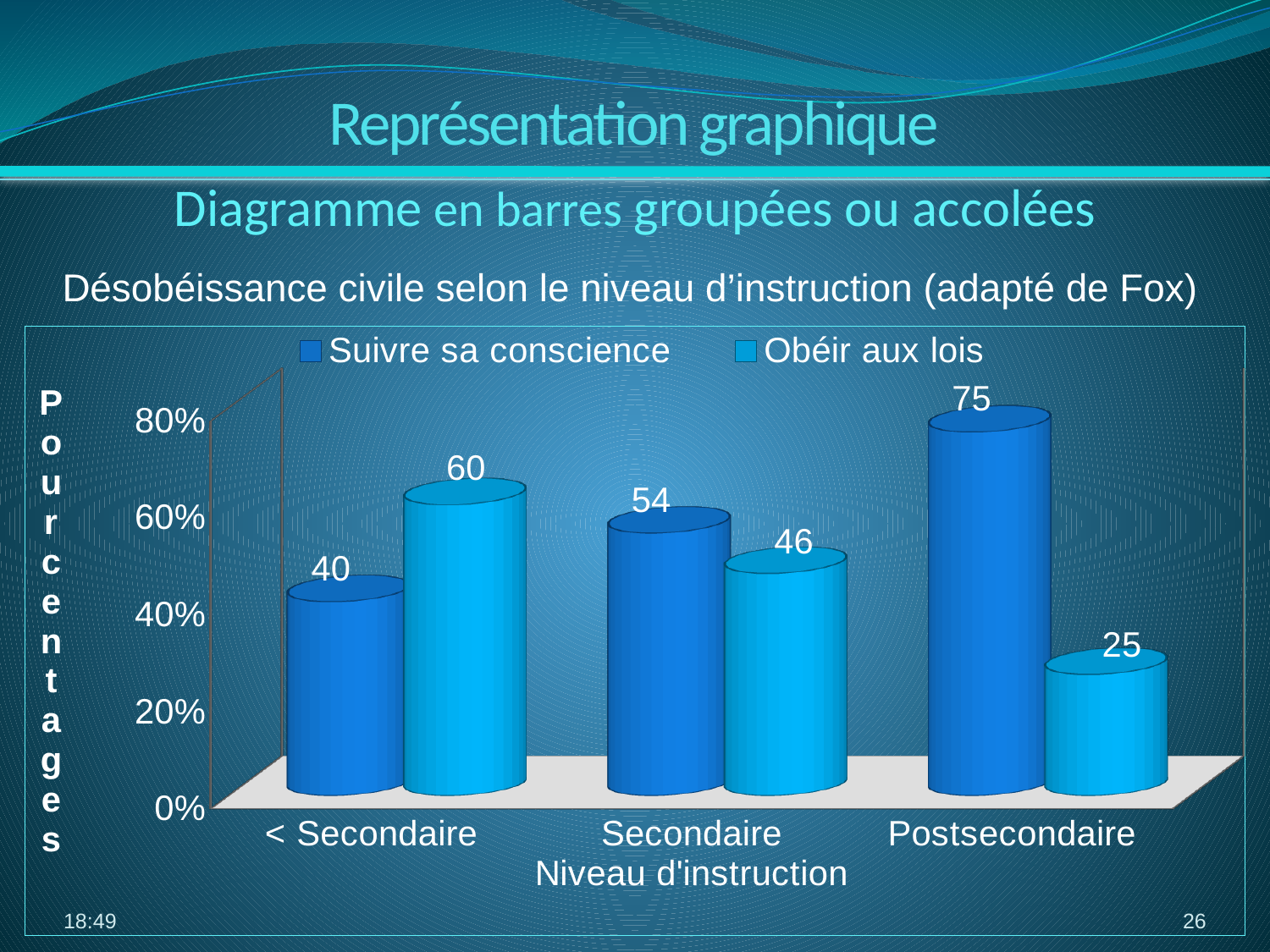
What is the difference between "Suivre sa conscience" and "Obéir aux lois" in the "Postsecondaire" category? 50 What kind of chart is shown on the slide? bar chart What is the label of the x axis? Niveau d'instruction In the "< Secondaire" category, which series has the larger value, "Suivre sa conscience" or "Obéir aux lois"? Obéir aux lois Which education level has the lowest value for "Obéir aux lois"? Postsecondaire Is the value for "Suivre sa conscience" in the "Secondaire" category greater or less than 60%? less Which education level has the highest value for "Suivre sa conscience"? Postsecondaire How many education level categories are shown on the x axis? 3 What is the value for "Suivre sa conscience" in the "< Secondaire" category? 40 What is the value for "Obéir aux lois" in the "Postsecondaire" category? 25 How many series does the legend list? 2 What is the value for "Obéir aux lois" in the "Secondaire" category? 46